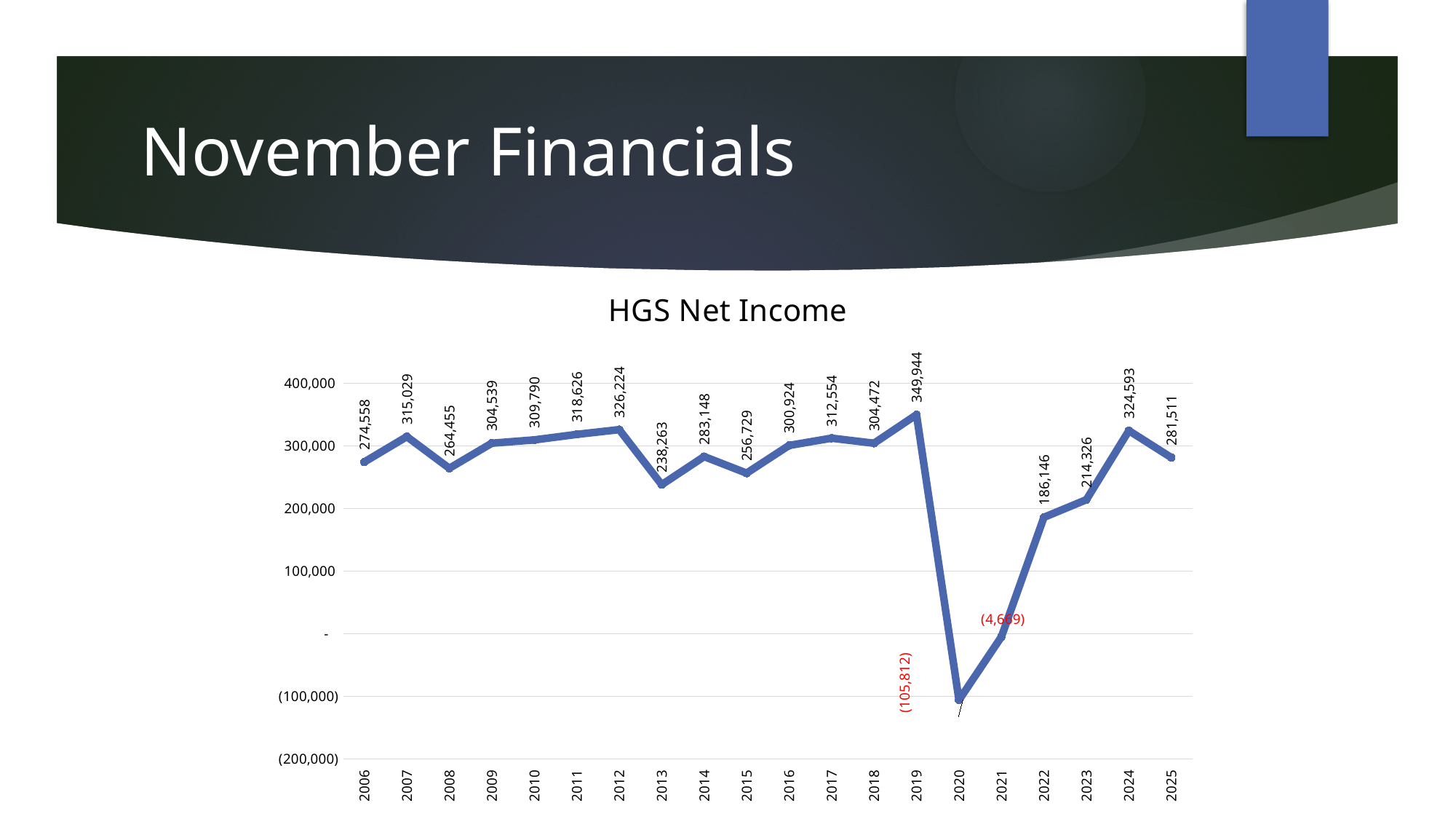
What is the HGS Net Income value for 2025? 281,511 Does HGS Net Income rise or fall from 2021 to 2024? rise Which year has the lowest HGS Net Income? 2020 Which year has the highest HGS Net Income? 2019 What kind of chart is used to show HGS Net Income? line chart What is the HGS Net Income value for 2019? 349,944 Is the HGS Net Income value for 2022 greater or less than 200,000? less Which year has the larger HGS Net Income, 2012 or 2013? 2012 How many years are plotted on the HGS Net Income chart? 20 What is the HGS Net Income value for 2020? (105,812) What is the difference between the HGS Net Income for 2024 and 2025? 43,082 What is the HGS Net Income value for 2013? 238,263